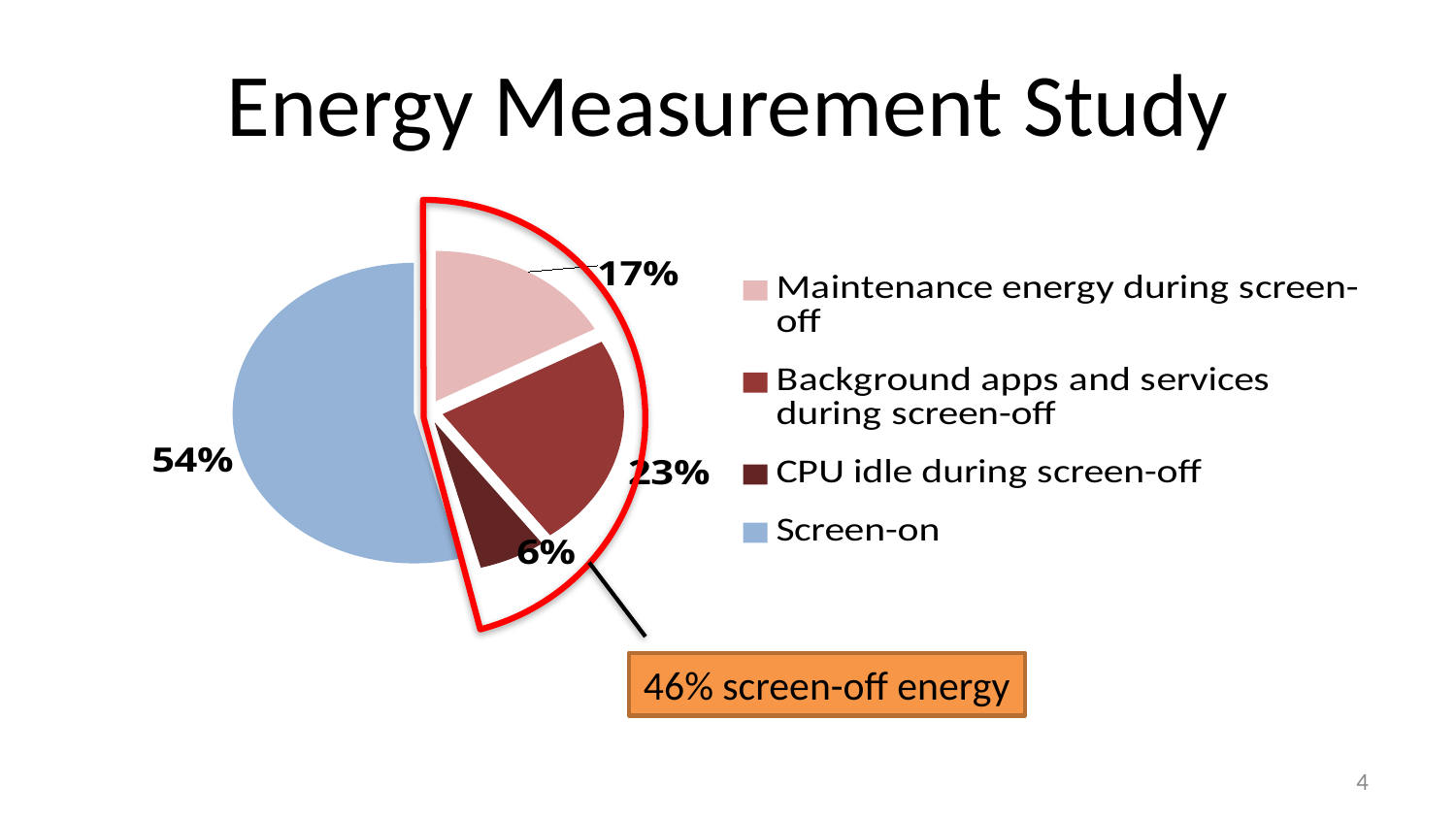
What percentage is shown for Maintenance energy during screen-off? 17% What share of energy does the Screen-on slice represent? 54% What kind of chart is shown on the slide? pie chart What is the difference in percentage points between Background apps and services during screen-off and Maintenance energy during screen-off? 6 What percentage is shown for CPU idle during screen-off? 6% Which is larger: Maintenance energy during screen-off or CPU idle during screen-off? Maintenance energy during screen-off Which slice of the pie is the largest? Screen-on Which slice of the pie is the smallest? CPU idle during screen-off What percentage is shown for Background apps and services during screen-off? 23% How many slices does the pie chart have? 4 What does the orange callout box below the chart say? 46% screen-off energy How many entries does the legend list? 4